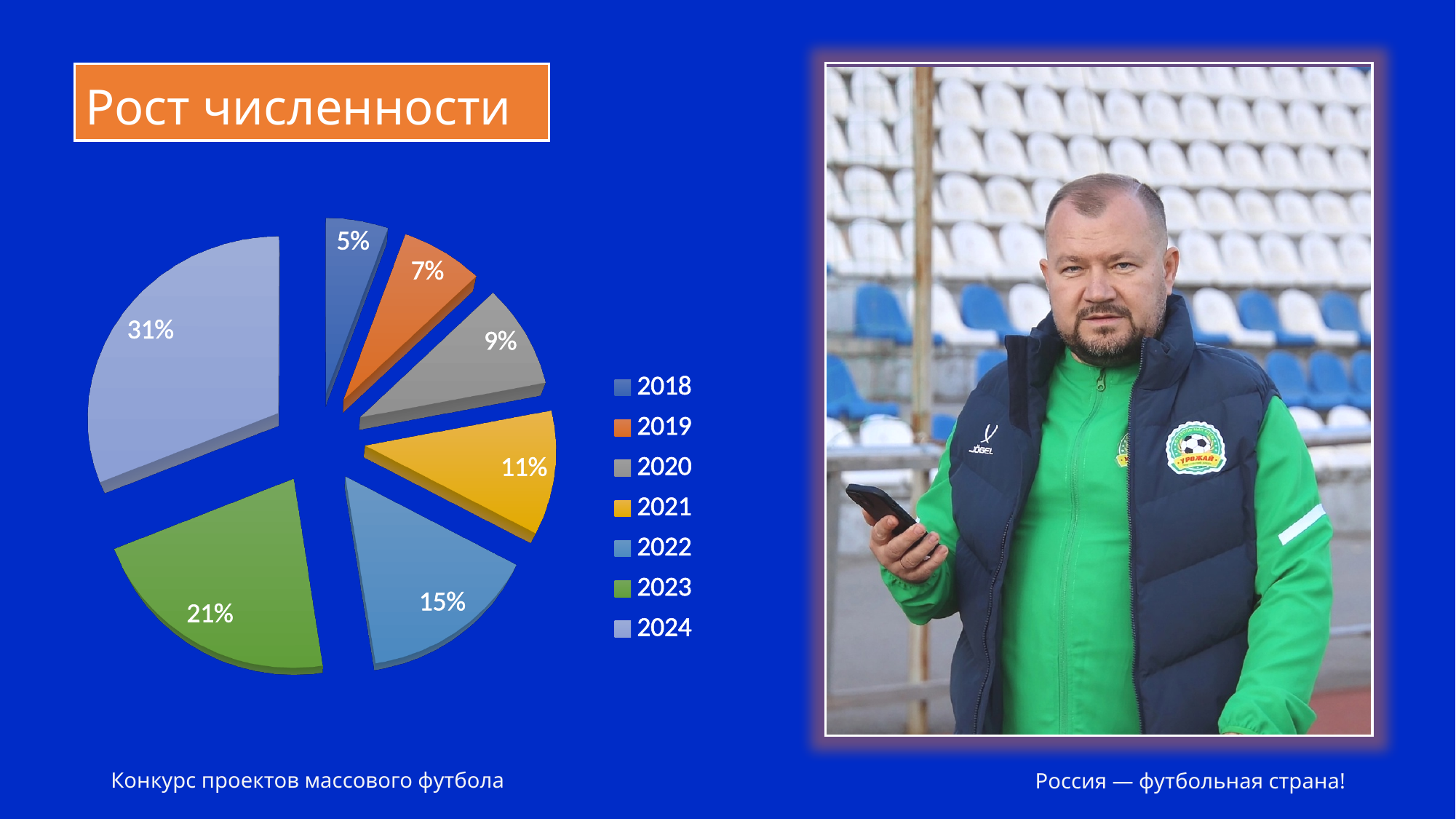
What share of the pie does 2023 have? 21% What is the difference between the shares for 2022 and 2019? 8% Which year has the smallest slice of the pie? 2018 What share of the pie does 2021 have? 11% Which year has the largest slice of the pie? 2024 What is the difference between the shares for 2024 and 2023? 10% Which is larger, the share for 2020 or the share for 2022? 2022 What is the title of the slide containing the pie chart? Рост численности What kind of chart is shown on the slide? pie chart What share of the pie does 2018 have? 5% How many years are listed in the chart legend? 7 What share of the pie does 2024 have? 31%